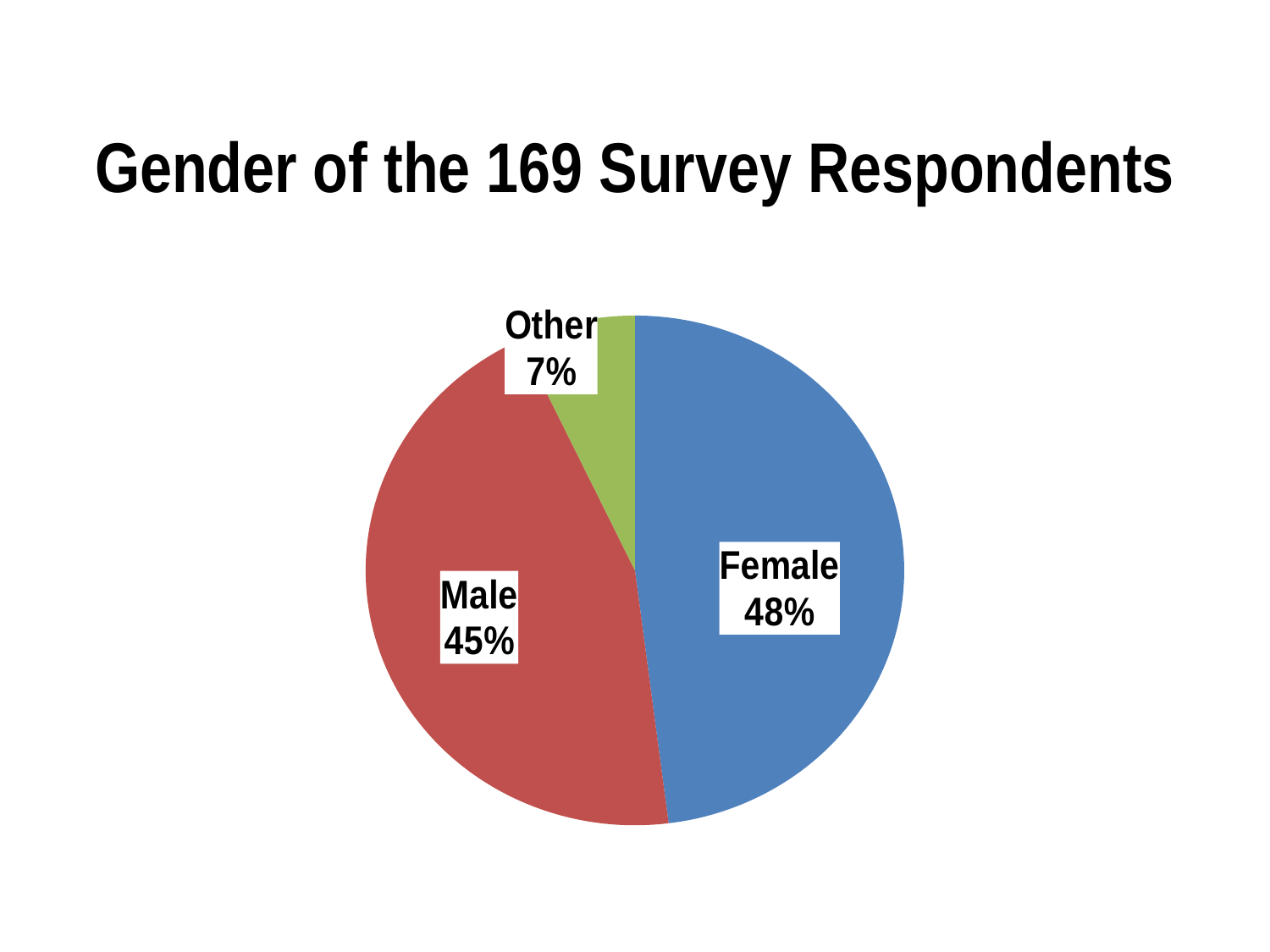
What colour is the Female slice of the pie chart? blue Which gender category has the largest share of respondents? Female What is the difference in percentage points between the Female and Male shares? 3 percentage points What share of the survey respondents are Female? 48% Which is larger, the Male share or the Other share? Male What is the difference in percentage points between the Male and Other shares? 38 percentage points How many slices does the pie chart have? 3 Which gender category has the smallest share of respondents? Other What is the title of the slide? Gender of the 169 Survey Respondents What share of the survey respondents are listed as Other? 7% What share of the survey respondents are Male? 45% What kind of chart is shown on the slide? pie chart